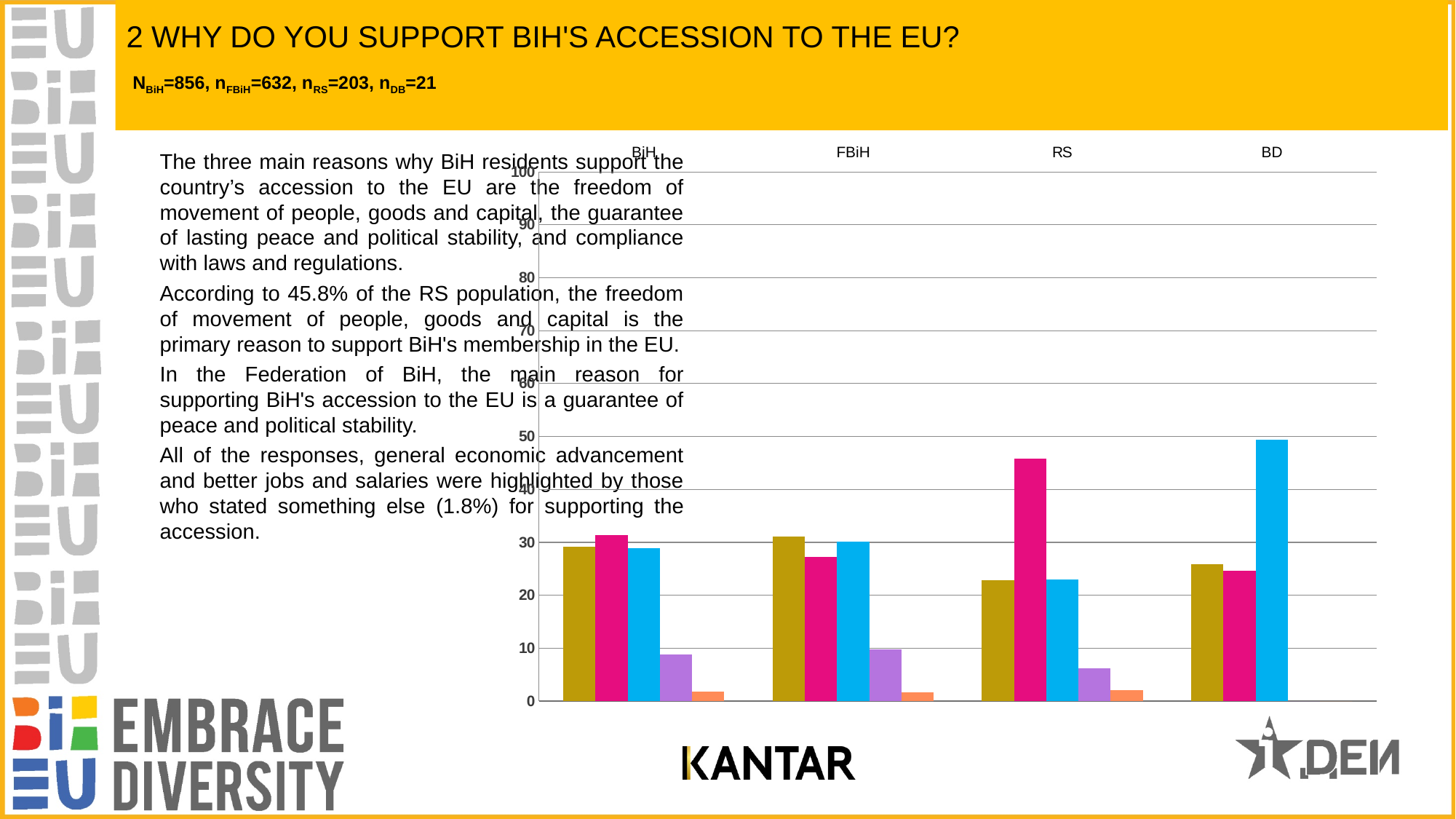
In which category is the magenta bar the tallest? RS What is the highest value shown on the chart's y axis? 100 What are the category labels along the x axis of the chart? BiH, FBiH, RS, BD How many categories are shown along the x axis of the chart? 4 Is the value of the orange bar for BiH greater or less than 10? less For RS, which is larger: the magenta bar or the olive bar? the magenta bar Is the value of the blue bar for BD greater or less than 40? greater For BD, which is larger: the blue bar or the olive bar? the blue bar Is the value of the olive bar for RS greater or less than 30? less What kind of chart is shown on the slide? bar chart In which category is the blue bar the tallest? BD